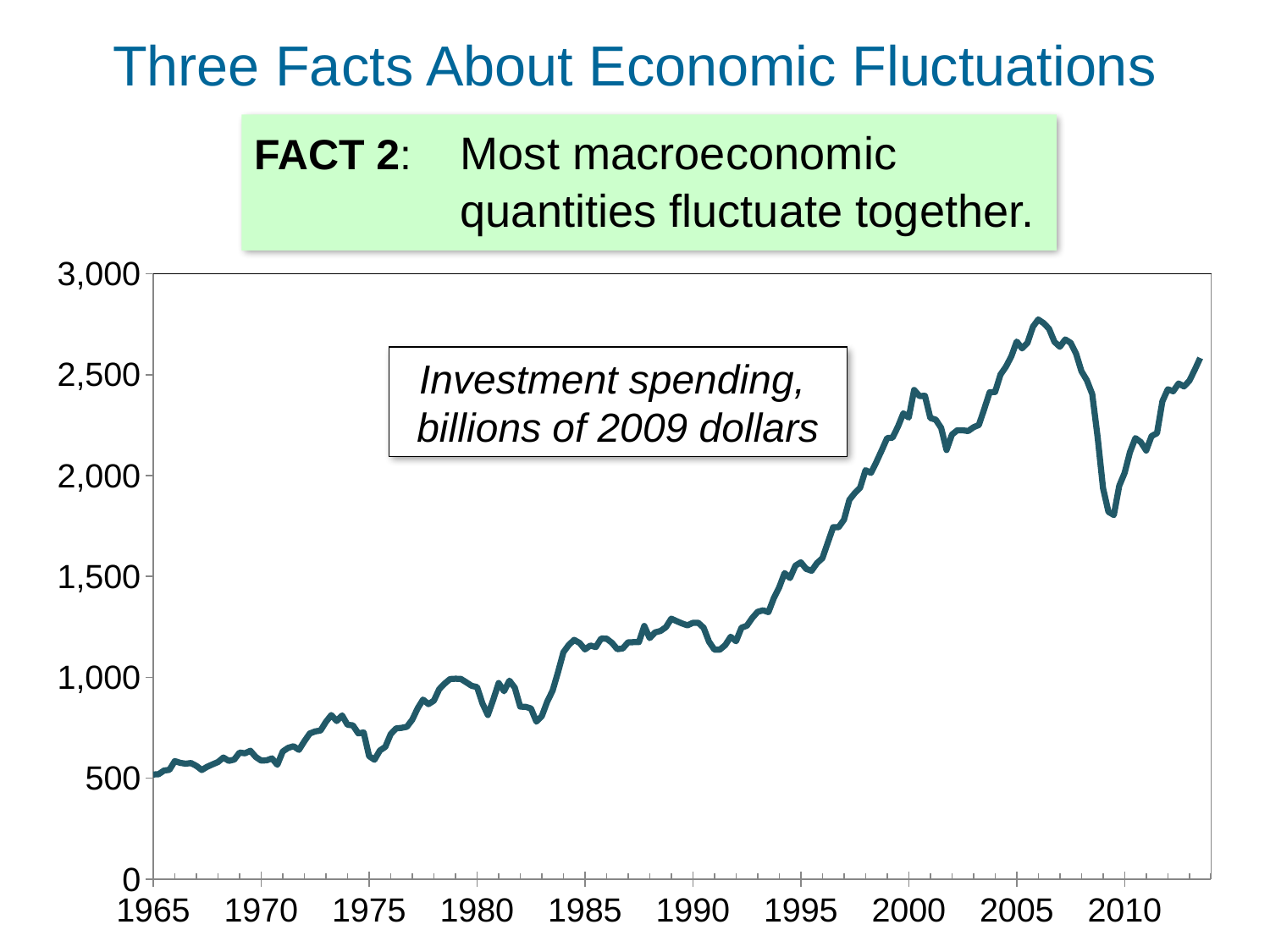
Is the value of investment spending in 1975 greater or less than 1,000? less Is the value of investment spending in 2000 greater or less than 2,000? greater How many lines (series) are plotted on the chart? 1 Is the value of investment spending in 1995 greater or less than 1,000? greater Overall, does investment spending rise or fall from 1965 to the end of the series? rise What kind of chart is shown on the slide? line chart What quantity does the line on the chart represent, according to the label on the chart? Investment spending, billions of 2009 dollars Which is larger, investment spending in 2010 or in 1965? 2010 What is the highest value shown on the vertical axis? 3,000